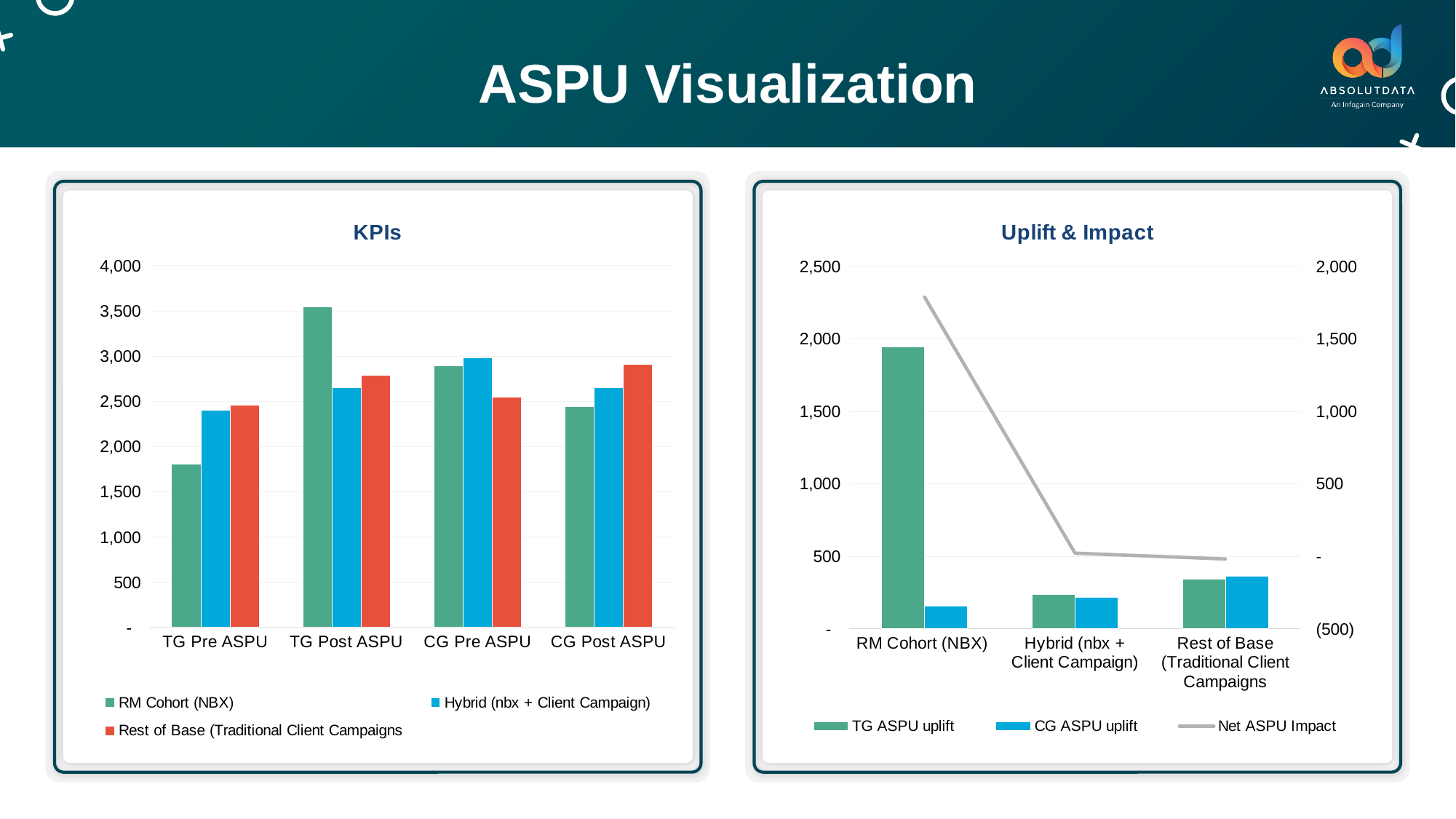
On the KPIs chart, is the RM Cohort (NBX) value for TG Pre ASPU greater or less than 2,000? less On the Uplift & Impact chart, which category has the highest TG ASPU uplift bar? RM Cohort (NBX) On the Uplift & Impact chart, how many categories are shown on the x axis? 3 On the KPIs chart, is the RM Cohort (NBX) value for TG Post ASPU greater or less than 3,000? greater On the KPIs chart, which category has the highest RM Cohort (NBX) bar? TG Post ASPU On the KPIs chart, which category has the lowest RM Cohort (NBX) bar? TG Pre ASPU On the KPIs chart, for TG Pre ASPU, which is larger: RM Cohort (NBX) or Hybrid (nbx + Client Campaign)? Hybrid (nbx + Client Campaign) On the Uplift & Impact chart, does the Net ASPU Impact line rise or fall from RM Cohort (NBX) to Rest of Base (Traditional Client Campaigns)? fall On the KPIs chart, what kind of chart is it? bar chart On the KPIs chart, how many categories are shown on the x axis? 4 On the KPIs chart, how many series does the legend list? 3 On the Uplift & Impact chart, how many series does the legend list? 3